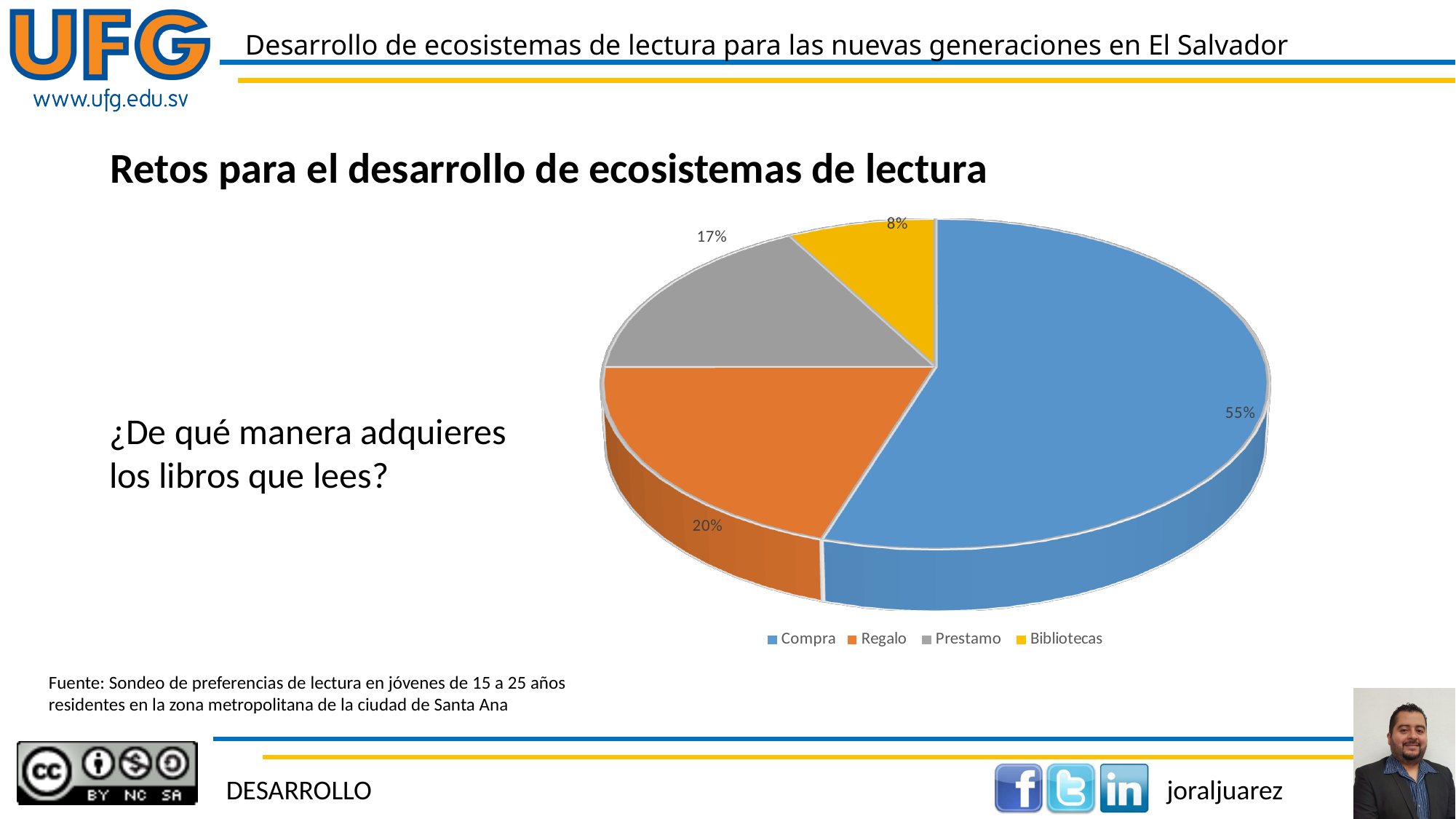
What is the difference in percentage points between Prestamo and Bibliotecas? 9 Which is larger, Regalo or Prestamo? Regalo Which category has the smallest slice of the pie chart? Bibliotecas What percentage of the pie chart is Prestamo? 17% What percentage of the pie chart is Bibliotecas? 8% What percentage of the pie chart is Regalo? 20% What colour is the Bibliotecas slice in the pie chart? Yellow What kind of chart is shown on the slide? Pie chart What percentage of the pie chart is Compra? 55% What is the difference in percentage points between Compra and Regalo? 35 How many categories does the pie chart show? 4 Which category has the largest slice of the pie chart? Compra